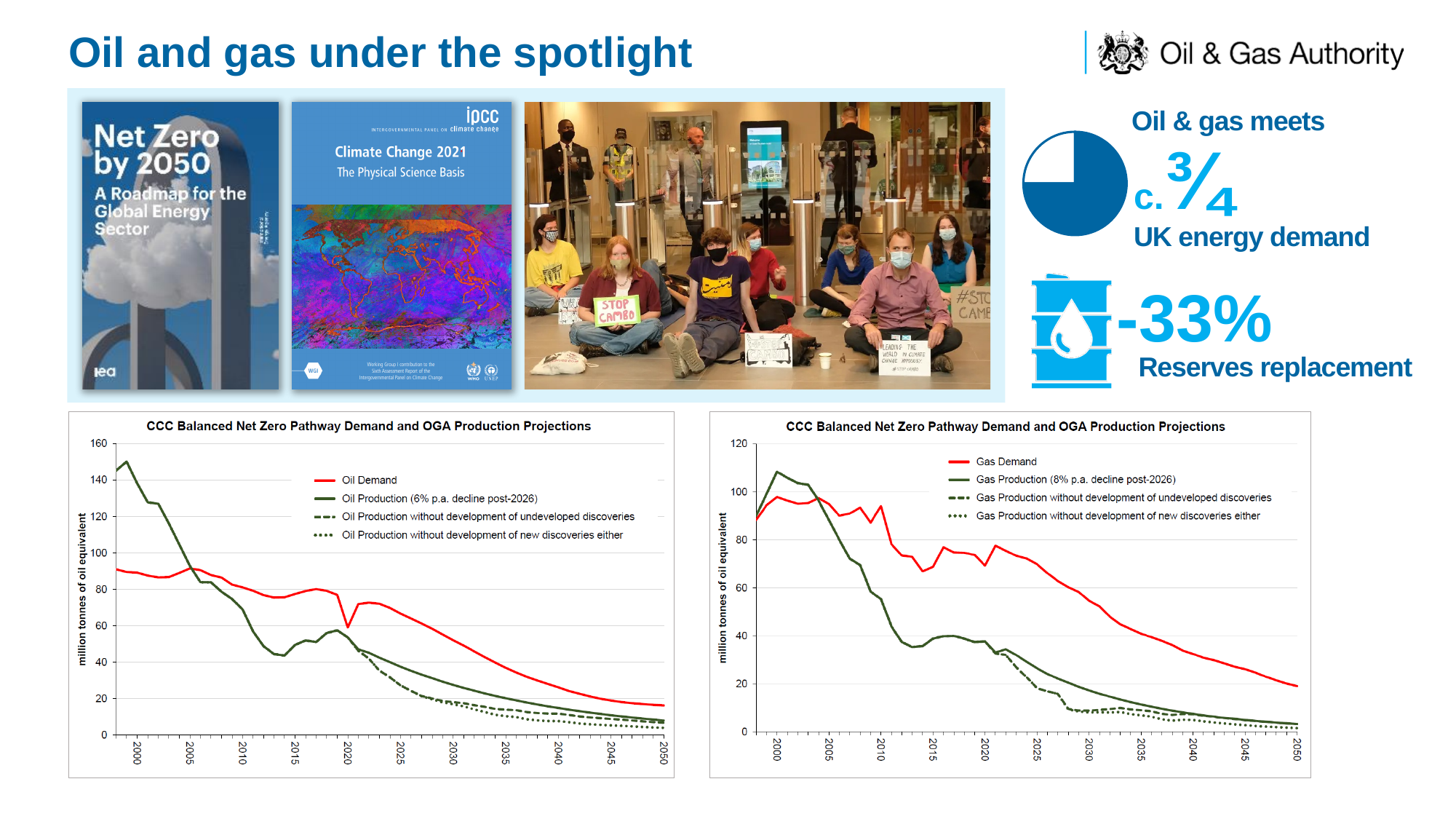
In the left chart (oil), which is larger in 2040: Oil Demand or Oil Production? Oil Demand In the right chart (gas), does Gas Demand rise or fall between 2030 and 2050? fall What is the y-axis label of the left chart (oil)? million tonnes of oil equivalent In the left chart (oil), which is larger in 2000: Oil Demand or Oil Production? Oil Production In the left chart (oil), is the value for Oil Production in 2000 greater or less than 140? greater In the left chart (oil), is the value for Oil Demand in 2050 greater or less than 20? less In the right chart (gas), what annual decline rate post-2026 does the Gas Production legend entry state? 8% p.a. What kind of chart is the left chart titled 'CCC Balanced Net Zero Pathway Demand and OGA Production Projections'? line chart In the left chart (oil), is the value for Oil Demand in 2000 greater or less than 100? less How many series does the legend of the right chart (gas) list? 4